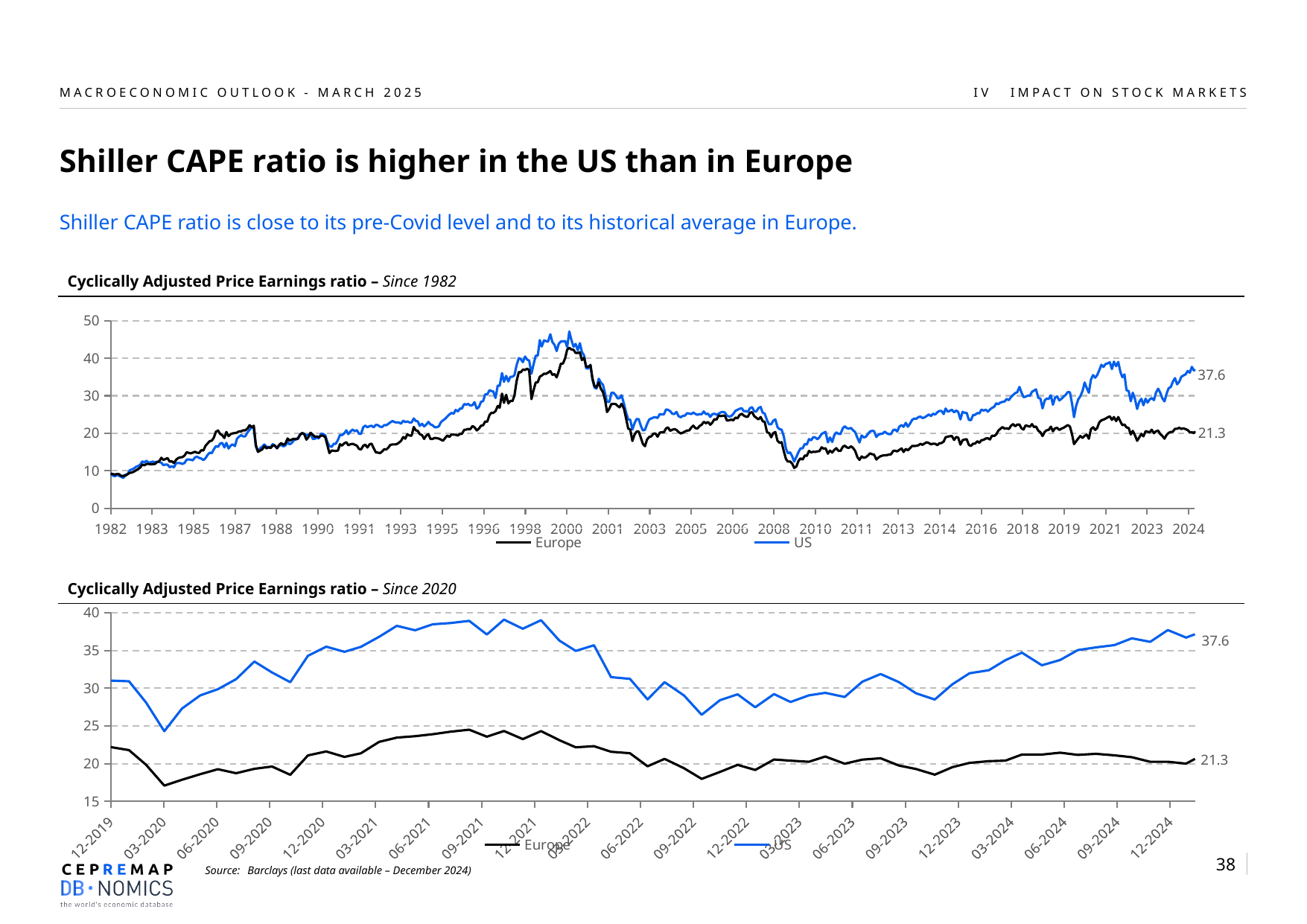
In the 'Since 1982' chart, what is the latest value shown for the US series? 37.6 In the 'Since 1982' chart, is the US value around 2000 greater or less than 40? greater In the 'Since 2020' chart, which series has the higher latest value, US or Europe? US In the 'Since 1982' chart, which colour is used for the US series? Blue How many series does the legend of the 'Since 2020' chart list? 2 In the 'Since 2020' chart, what is the difference between the latest US value and the latest Europe value? 16.3 In the 'Since 2020' chart, is the US value at 03-2020 greater or less than 25? less In the 'Since 1982' chart, what is the latest value shown for the Europe series? 21.3 What kind of chart is the 'Since 1982' chart? Line chart In the 'Since 2020' chart, does the US series rise or fall between 12-2022 and 12-2024? rise In the 'Since 2020' chart, is the Europe value at 09-2021 greater or less than 20? greater What is the title of the lower chart on the slide? Cyclically Adjusted Price Earnings ratio – Since 2020